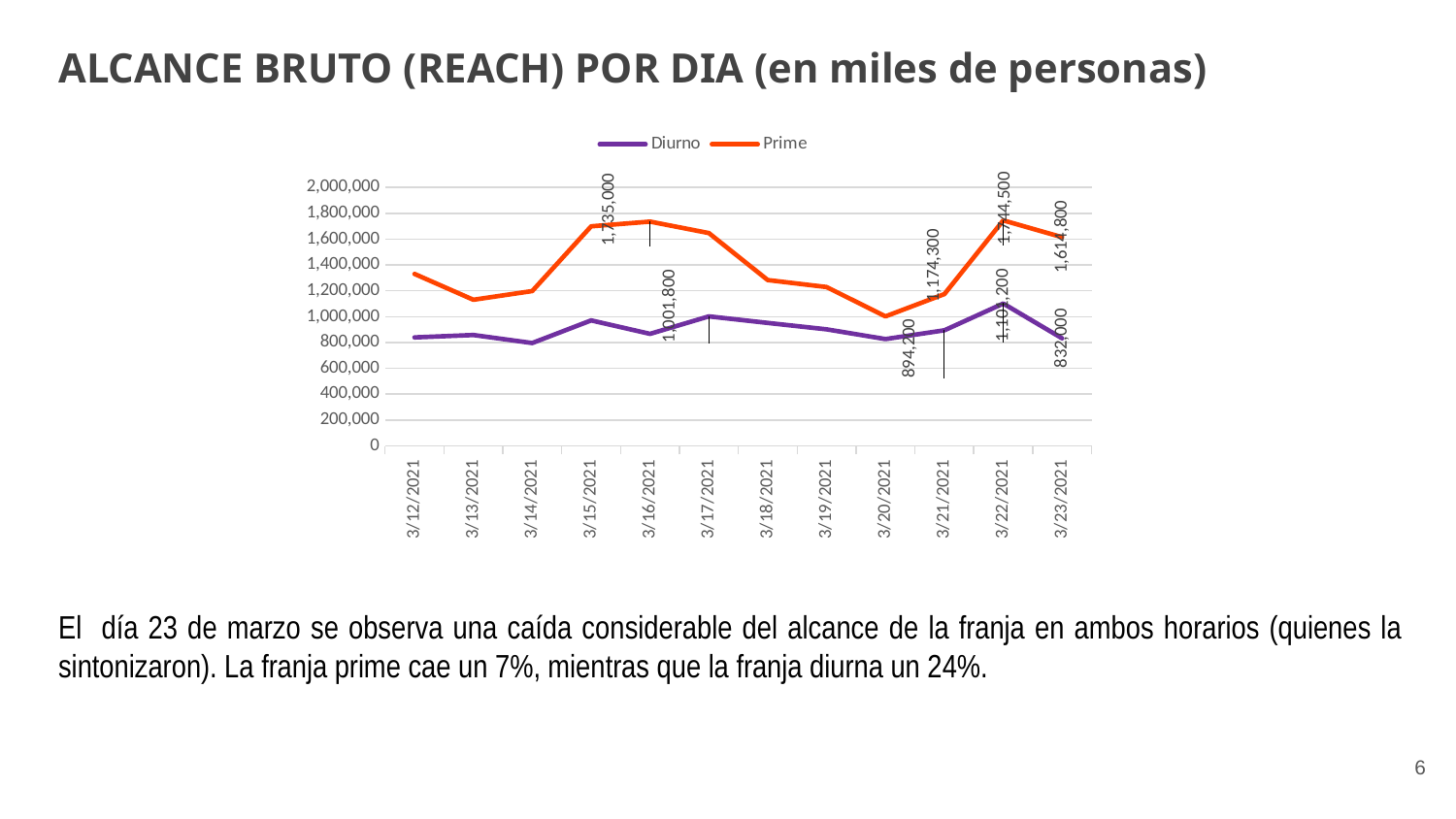
What is the Prime value on 3/23/2021? 1,614,800 What is the Diurno value on 3/22/2021? 1,101,200 What is the Diurno value on 3/23/2021? 832,000 By how much did the Diurno value fall from 3/22/2021 to 3/23/2021? 269,200 By how much did the Prime value fall from 3/22/2021 to 3/23/2021? 129,700 How many series does the legend list? 2 What is the Diurno value on 3/21/2021? 894,200 What type of chart is shown on the slide? Line chart Is the Diurno value on 3/12/2021 greater or less than 1,000,000? less What is the Prime value on 3/22/2021? 1,744,500 On 3/21/2021, which series has the larger value, Diurno or Prime? Prime How many dates are plotted along the x axis? 12